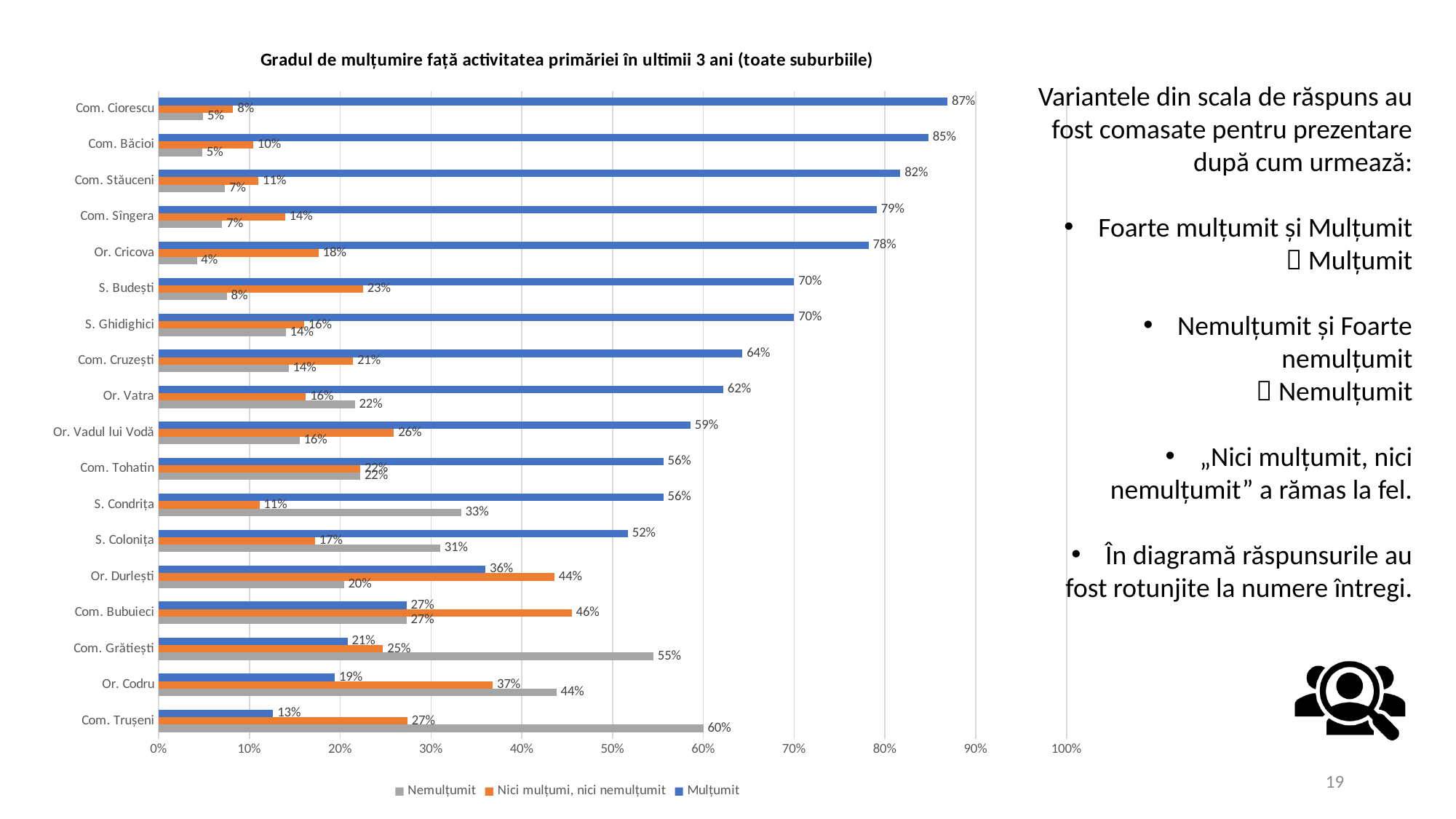
Which category has the highest Nemulțumit value? Com. Trușeni Which category has the highest Mulțumit value? Com. Ciorescu What is the 'Nici mulțumi, nici nemulțumit' value for Or. Durlești? 44% What is the difference between the Mulțumit values of Com. Băcioi and Or. Codru? 66% What is the title of the chart? Gradul de mulțumire față activitatea primăriei în ultimii 3 ani (toate suburbiile) Which category has the lowest Mulțumit value? Com. Trușeni What is the Mulțumit value for Com. Ciorescu? 87% What is the Nemulțumit value for Com. Trușeni? 60% How many categories (localities) are shown on the chart? 18 Which is larger for Com. Grătiești: the Nemulțumit value or the Mulțumit value? Nemulțumit What kind of chart is shown on the slide? Bar chart How many series does the legend list? 3